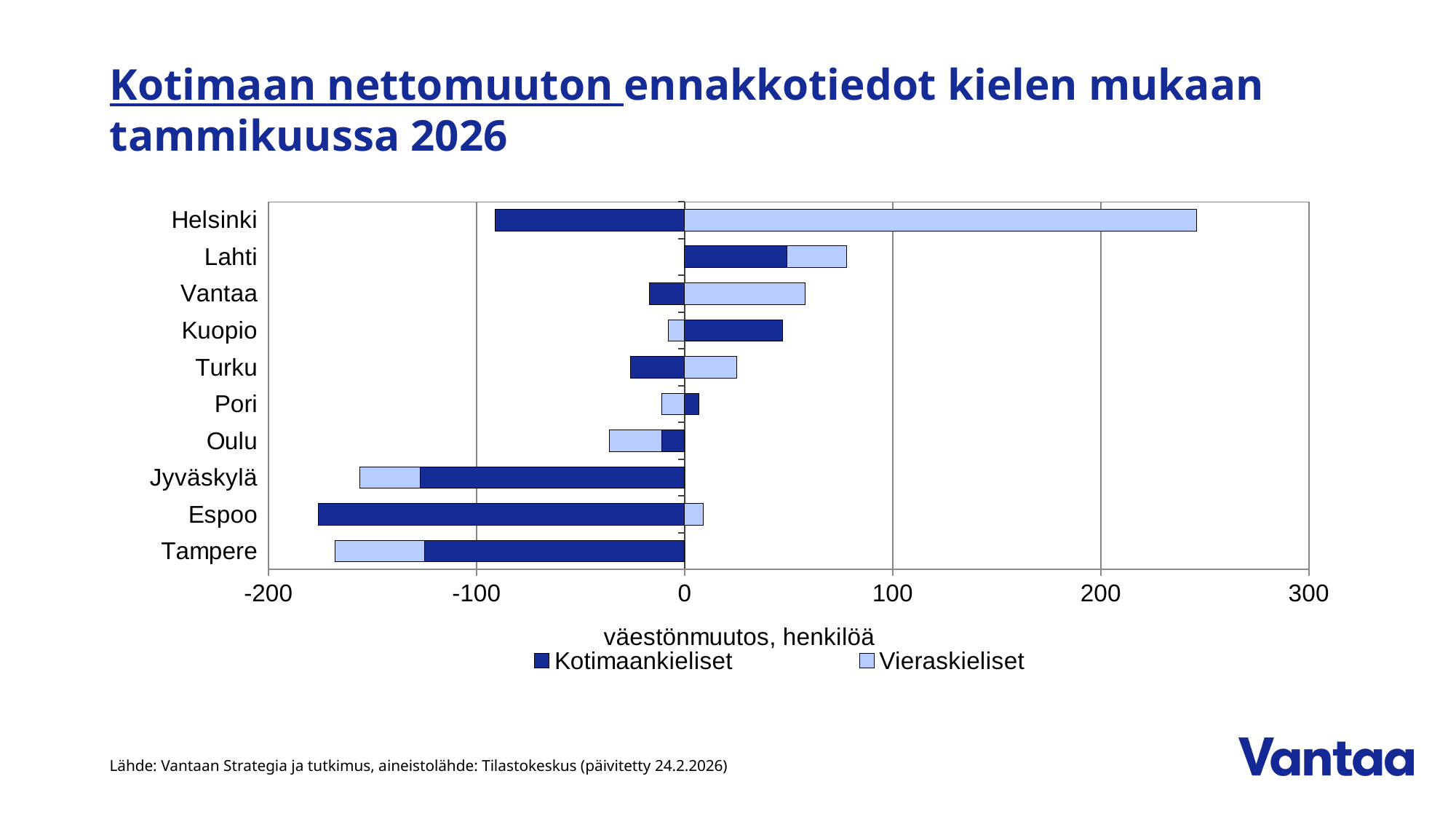
Which city has the lowest Kotimaankieliset value? Espoo Which is larger, the Vieraskieliset value for Vantaa or for Turku? Vantaa How many cities are shown on the chart? 10 How many series does the legend list? 2 Is the Vieraskieliset value for Helsinki greater or less than 200? greater What kind of chart is shown on the slide? bar chart Is the Kotimaankieliset value for Jyväskylä greater or less than -100? less Is the Kotimaankieliset value for Lahti greater or less than 0? greater Which is larger, the Kotimaankieliset value for Helsinki or for Turku? Turku What is the title of the x axis? väestönmuutos, henkilöä Which city has the highest Vieraskieliset value? Helsinki